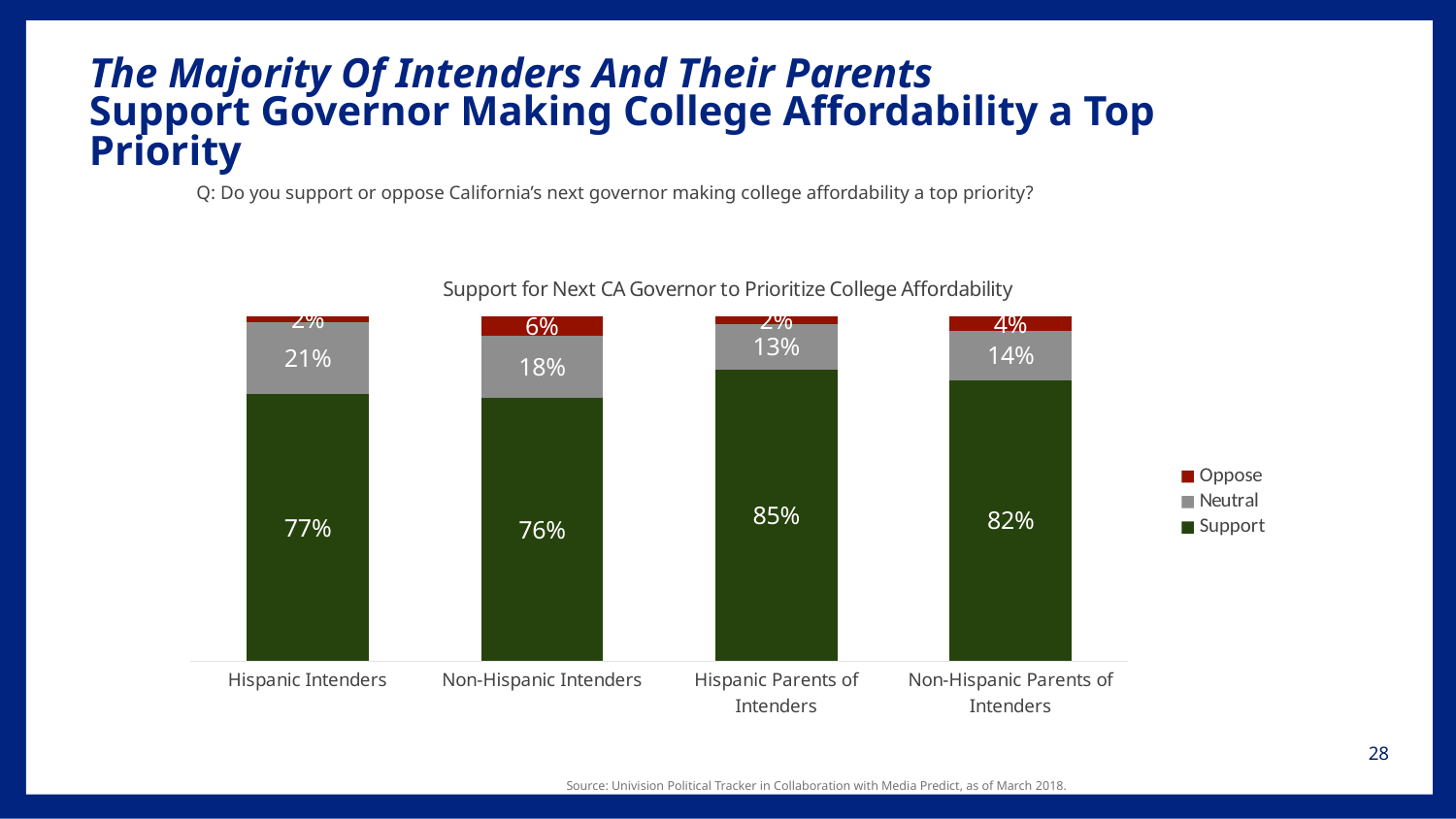
What percentage of Hispanic Intenders support the next governor prioritizing college affordability? 77% How many groups are shown on the x axis of the chart? 4 What type of chart is shown on the slide? Stacked bar chart What is the difference in Support between Hispanic Parents of Intenders and Hispanic Intenders? 8% What is the Neutral share for Non-Hispanic Intenders? 18% How many series does the legend list? 3 Which group has the highest Oppose percentage? Non-Hispanic Intenders Which is larger: the Neutral share for Hispanic Intenders or for Non-Hispanic Parents of Intenders? Hispanic Intenders Which group has the lowest Support percentage? Non-Hispanic Intenders What is the Oppose value for Non-Hispanic Parents of Intenders? 4% Which group has the highest Support percentage? Hispanic Parents of Intenders What percentage of Hispanic Parents of Intenders are Neutral? 13%